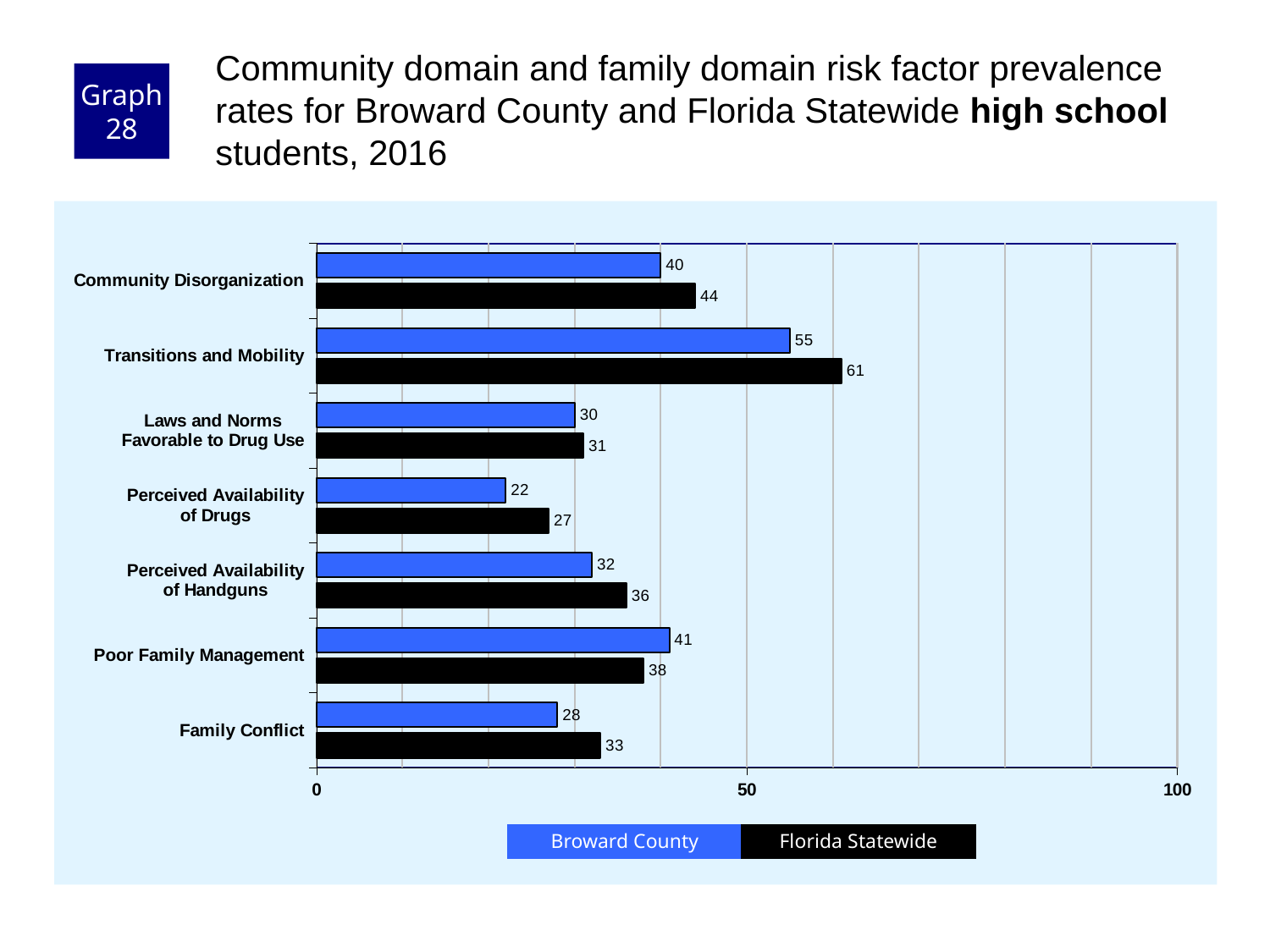
How many risk factor categories are shown on the chart? 7 Is the Florida Statewide value for Community Disorganization greater or less than 50? less What kind of chart is shown on the slide? bar chart Which colour represents Florida Statewide in the chart? black What is the Broward County value for Family Conflict? 28 Which risk factor has the lowest Broward County value? Perceived Availability of Drugs What is the difference between the Florida Statewide and Broward County values for Transitions and Mobility? 6 What is the Broward County value for Transitions and Mobility? 55 What is the Florida Statewide value for Perceived Availability of Drugs? 27 How many series does the legend list? 2 Which risk factor has the highest Florida Statewide value? Transitions and Mobility For Poor Family Management, which is larger: the Broward County value or the Florida Statewide value? Broward County